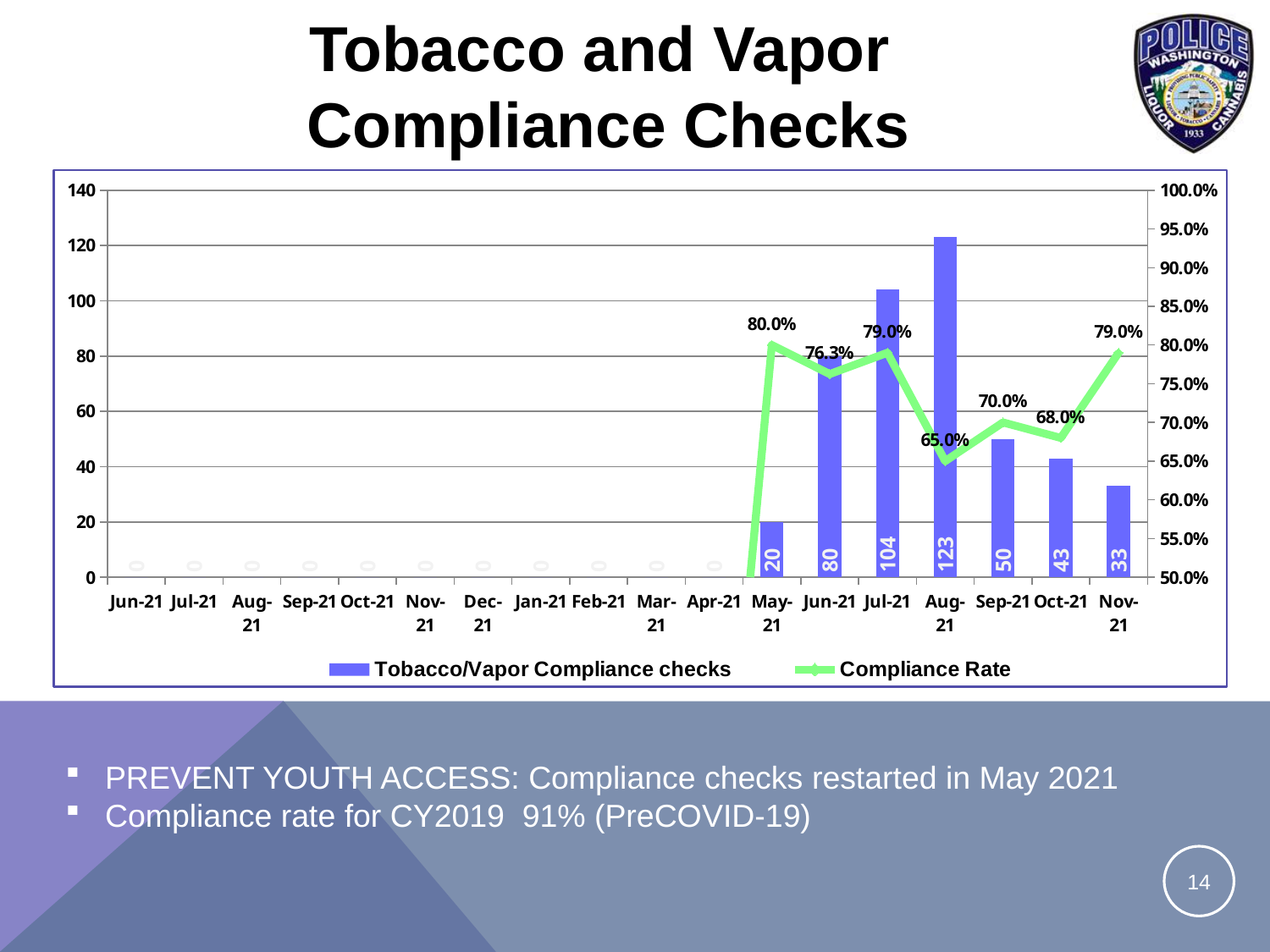
What is the difference between the highest bar (123) and the next highest bar (104)? 19 How many series does the legend list? 2 How many categories are shown on the x axis? 18 What is the lowest Compliance Rate shown on the chart? 65.0% Which month had more Tobacco/Vapor Compliance checks, May-21 or Nov-21? Nov-21 What is the highest number of Tobacco/Vapor Compliance checks shown in any month? 123 How many Tobacco/Vapor Compliance checks were done in May-21? 20 Do the Tobacco/Vapor Compliance checks rise or fall from Aug-21 to Nov-21? Fall What is the total number of Tobacco/Vapor Compliance checks across all months with bars (May-21 to Nov-21)? 453 What kind of chart is shown on the slide? A combination bar and line chart What was the Compliance Rate in May-21? 80.0% In which month did the number of Tobacco/Vapor Compliance checks peak? Aug-21